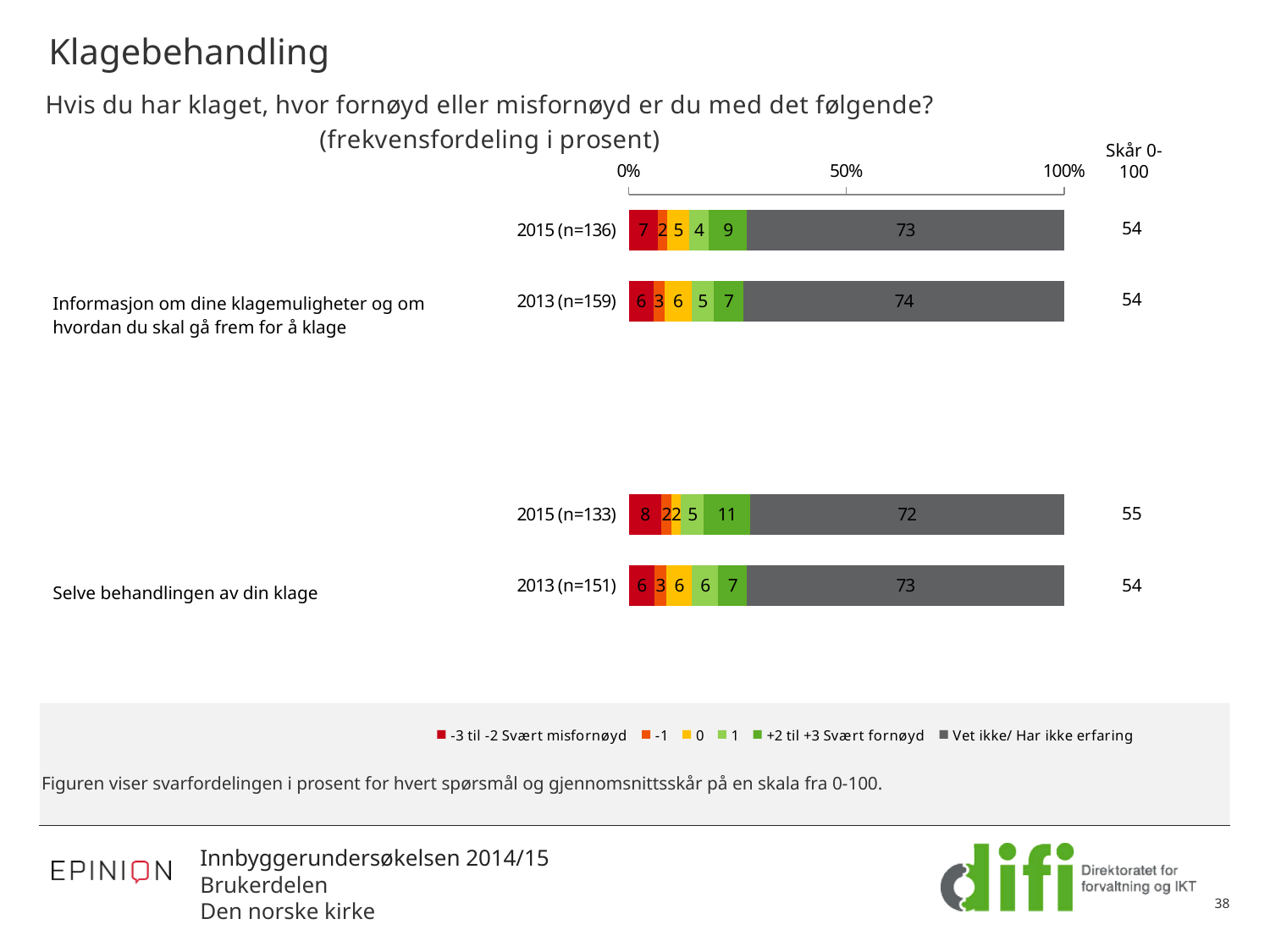
For 'Informasjon om dine klagemuligheter og om hvordan du skal gå frem for å klage', what is the 'Vet ikke/ Har ikke erfaring' value in the 2015 (n=136) bar? 73 For 'Selve behandlingen av din klage', what is the '-3 til -2 Svært misfornøyd' value in the 2015 (n=133) bar? 8 How many bars are plotted in the chart? 4 For 'Selve behandlingen av din klage', what is the '+2 til +3 Svært fornøyd' value in the 2015 (n=133) bar? 11 What kind of chart is shown on the slide? Stacked bar chart Which legend entry is shown in dark grey? Vet ikke/ Har ikke erfaring Which bar has the highest 'Skår 0-100' value? 2015 (n=133), Selve behandlingen av din klage For 'Informasjon om dine klagemuligheter og om hvordan du skal gå frem for å klage', what is the 'Vet ikke/ Har ikke erfaring' value in the 2013 (n=159) bar? 74 How many series does the chart legend list? 6 For 'Selve behandlingen av din klage', which year has the larger '+2 til +3 Svært fornøyd' value, 2015 (n=133) or 2013 (n=151)? 2015 (n=133) What is the 'Skår 0-100' value shown for the 2015 (n=133) bar under 'Selve behandlingen av din klage'? 55 For 'Informasjon om dine klagemuligheter', what is the difference between the 'Vet ikke/ Har ikke erfaring' values in 2013 (n=159) and 2015 (n=136)? 1